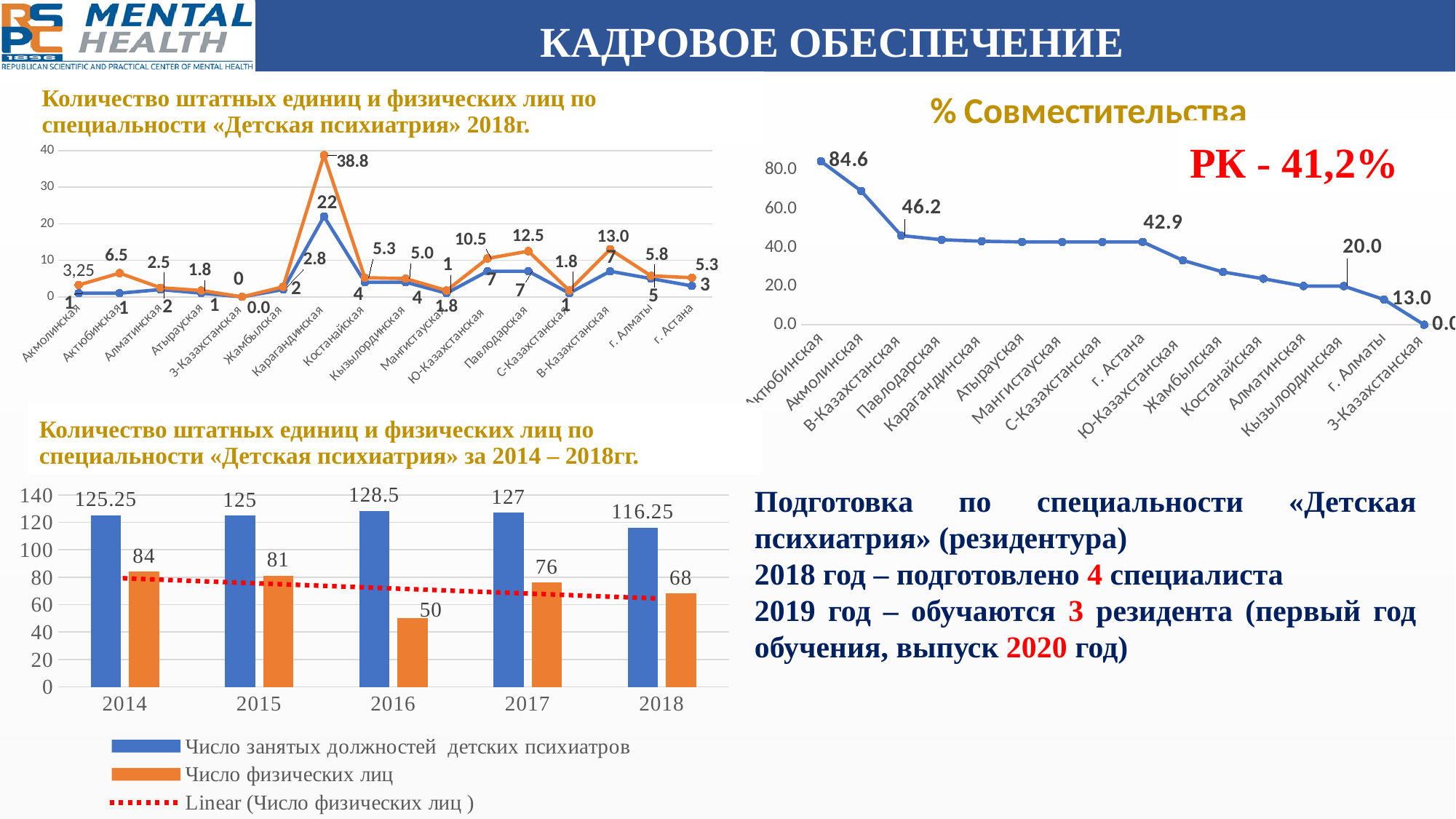
In the bottom-left chart for 2014–2018, which year has the lowest value of «Число физических лиц»? 2016 In the bottom-left chart for 2014–2018, how many entries does the legend list? 3 In the bottom-left chart for 2014–2018, what is the value of «Число занятых должностей детских психиатров» in 2016? 128.5 In the «% Совместительства» chart, what is the value for Актюбинская? 84.6 In the top-left chart for 2018, how many regions are shown on the x axis? 16 In the «% Совместительства» chart, is the value for Жамбылская greater or less than 40.0? less In the top-left chart for 2018, which region has the highest value? Карагандинская In the bottom-left chart for 2014–2018, what is the difference between «Число занятых должностей детских психиатров» and «Число физических лиц» in 2016? 78.5 In the «% Совместительства» chart, which region has the lowest value? З-Казахстанская In the bottom-left chart for 2014–2018, what is the value of «Число физических лиц» in 2018? 68 In the «% Совместительства» chart, do the values rise or fall from left to right? Fall What kind of chart is the bottom-left chart for 2014–2018? Bar chart